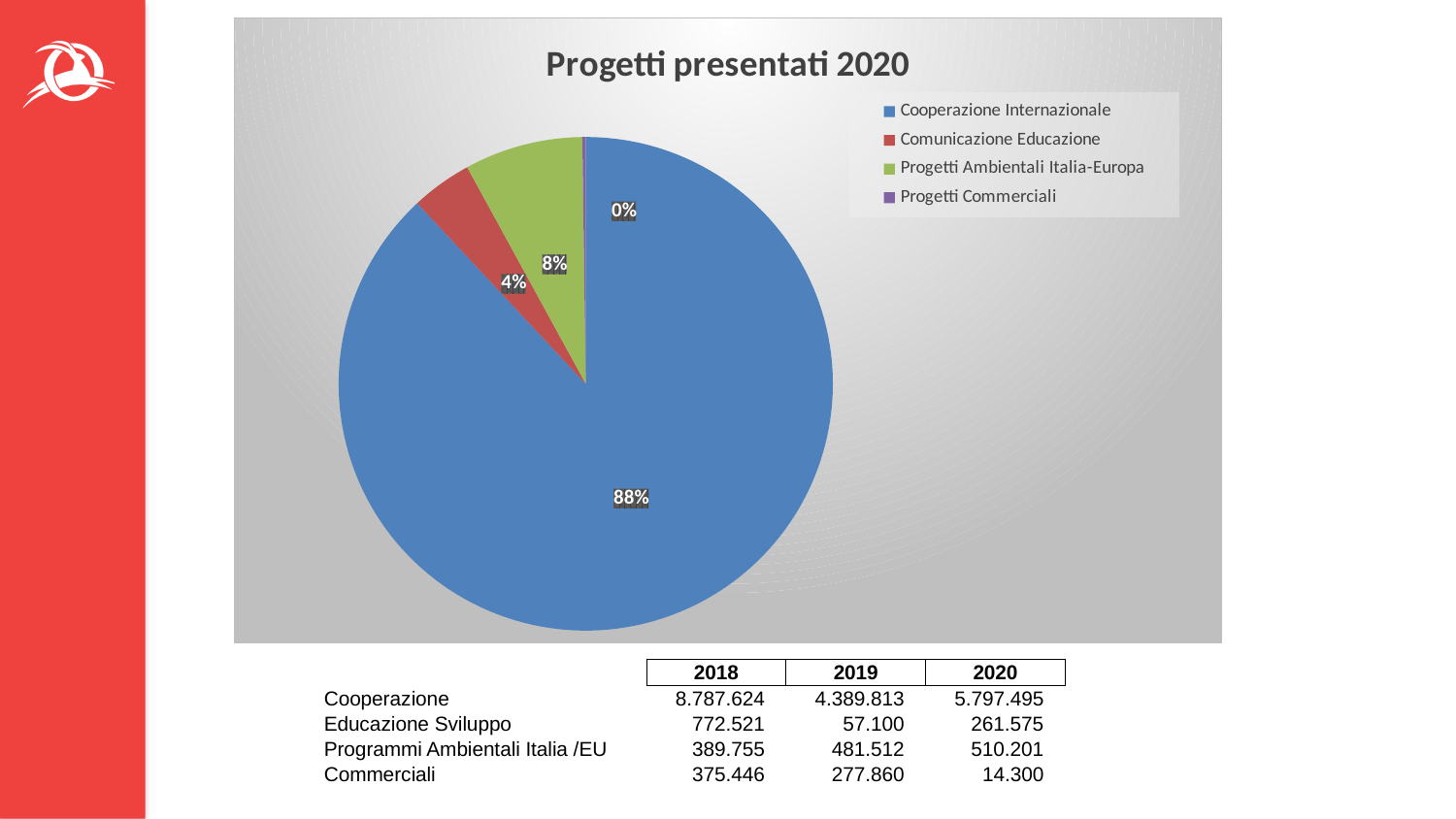
Which category has the largest slice of the pie? Cooperazione Internazionale What colour is the slice for Cooperazione Internazionale? blue What share of the pie does Progetti Commerciali represent? 0% Which is larger, the slice for Progetti Ambientali Italia-Europa or the slice for Comunicazione Educazione? Progetti Ambientali Italia-Europa What share of the pie does Cooperazione Internazionale represent? 88% Which category has the smallest slice of the pie? Progetti Commerciali What is the difference in percentage points between the Cooperazione Internazionale slice and the Progetti Ambientali Italia-Europa slice? 80% How many categories does the legend of the pie chart list? 4 What share of the pie does Progetti Ambientali Italia-Europa represent? 8% What is the title of the pie chart? Progetti presentati 2020 What kind of chart is shown on the slide? pie chart